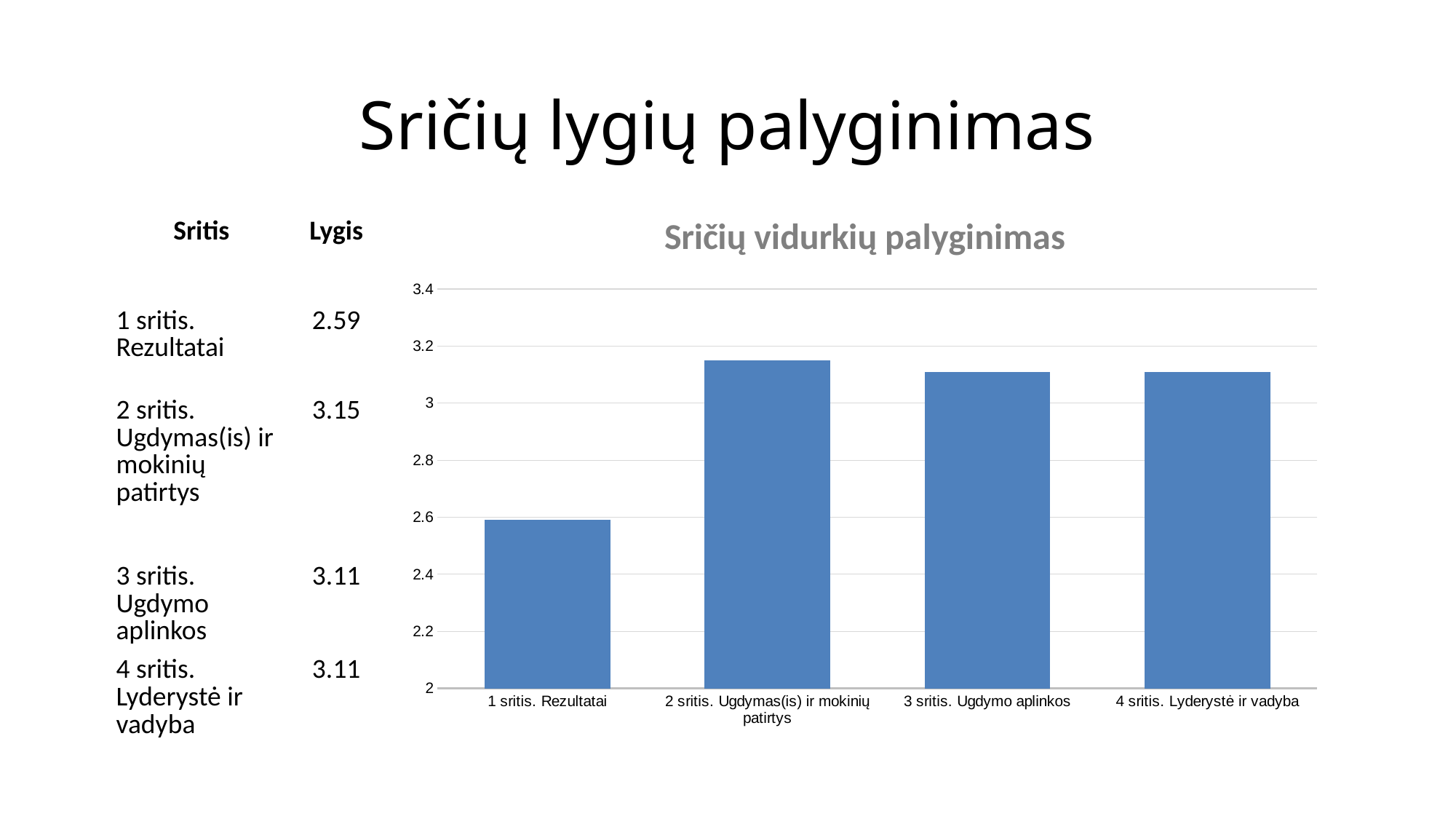
What is the value for "2 sritis. Ugdymas(is) ir mokinių patirtys"? 3.15 What is the value for "3 sritis. Ugdymo aplinkos"? 3.11 What is the difference between the values for "2 sritis. Ugdymas(is) ir mokinių patirtys" and "1 sritis. Rezultatai"? 0.56 What is the value for "4 sritis. Lyderystė ir vadyba"? 3.11 Which category has the highest value? 2 sritis. Ugdymas(is) ir mokinių patirtys What is the title of the chart? Sričių vidurkių palyginimas What is the value for "1 sritis. Rezultatai"? 2.59 Which category has the lowest value? 1 sritis. Rezultatai What type of chart is shown on the slide? bar chart How many categories (bars) does the chart show? 4 Is the value for "1 sritis. Rezultatai" greater or less than 2.8? less Which is larger, the value for "3 sritis. Ugdymo aplinkos" or "1 sritis. Rezultatai"? 3 sritis. Ugdymo aplinkos